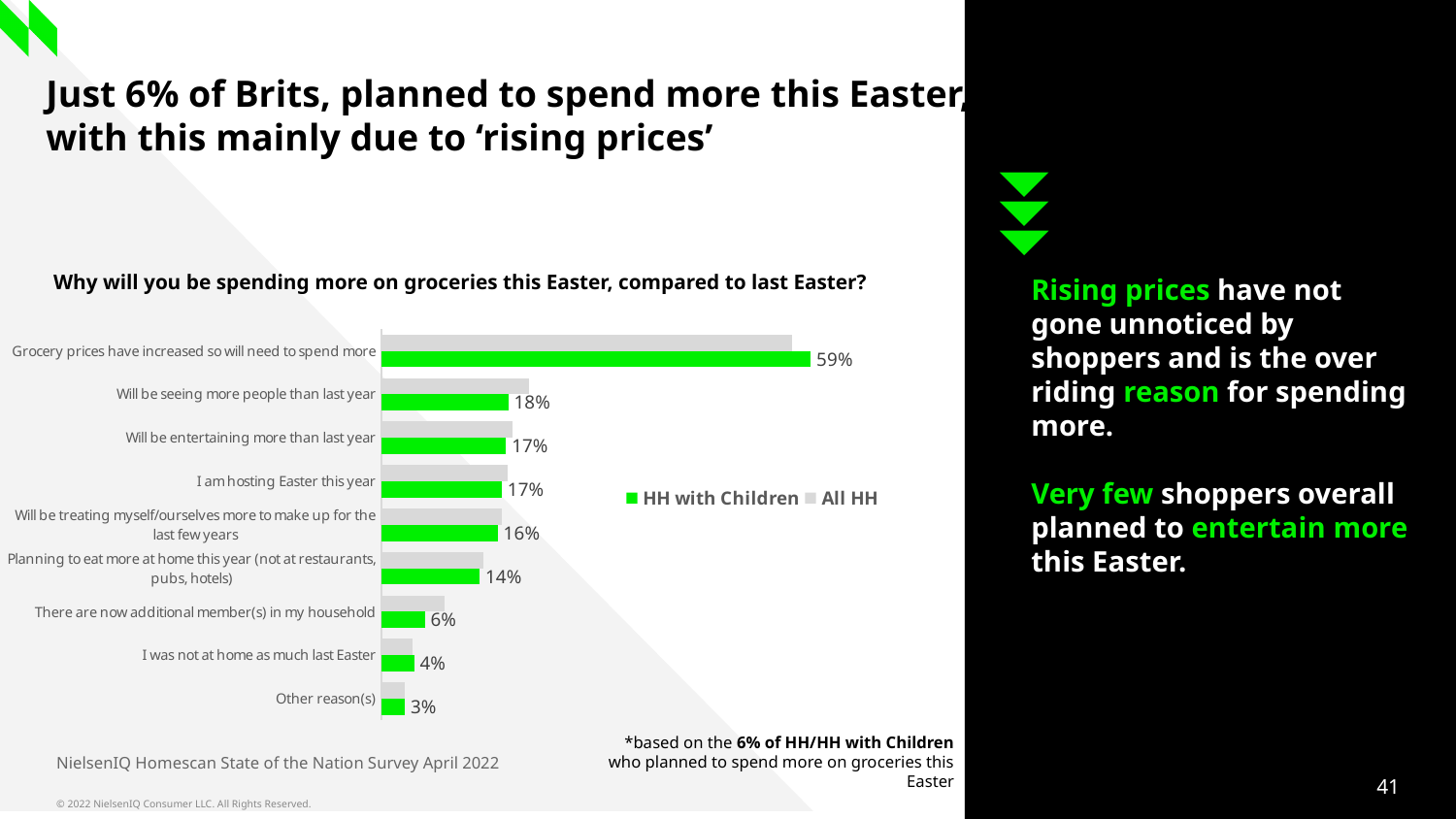
How many reasons (categories) are shown in the chart? 9 Which series is shown in green in the chart? HH with Children What is the HH with Children value for 'Planning to eat more at home this year (not at restaurants, pubs, hotels)'? 14% How many series does the chart legend list? 2 Which reason has the highest HH with Children value? Grocery prices have increased so will need to spend more What is the HH with Children value for 'Other reason(s)'? 3% What is the HH with Children value for 'Will be seeing more people than last year'? 18% What is the HH with Children value for 'Grocery prices have increased so will need to spend more'? 59% What kind of chart is shown on the slide? Bar chart For 'Will be seeing more people than last year', which series has the larger bar: HH with Children or All HH? All HH Which reason has the lowest HH with Children value? Other reason(s) What is the difference between the HH with Children values for 'Grocery prices have increased so will need to spend more' and 'Will be seeing more people than last year'? 41 percentage points